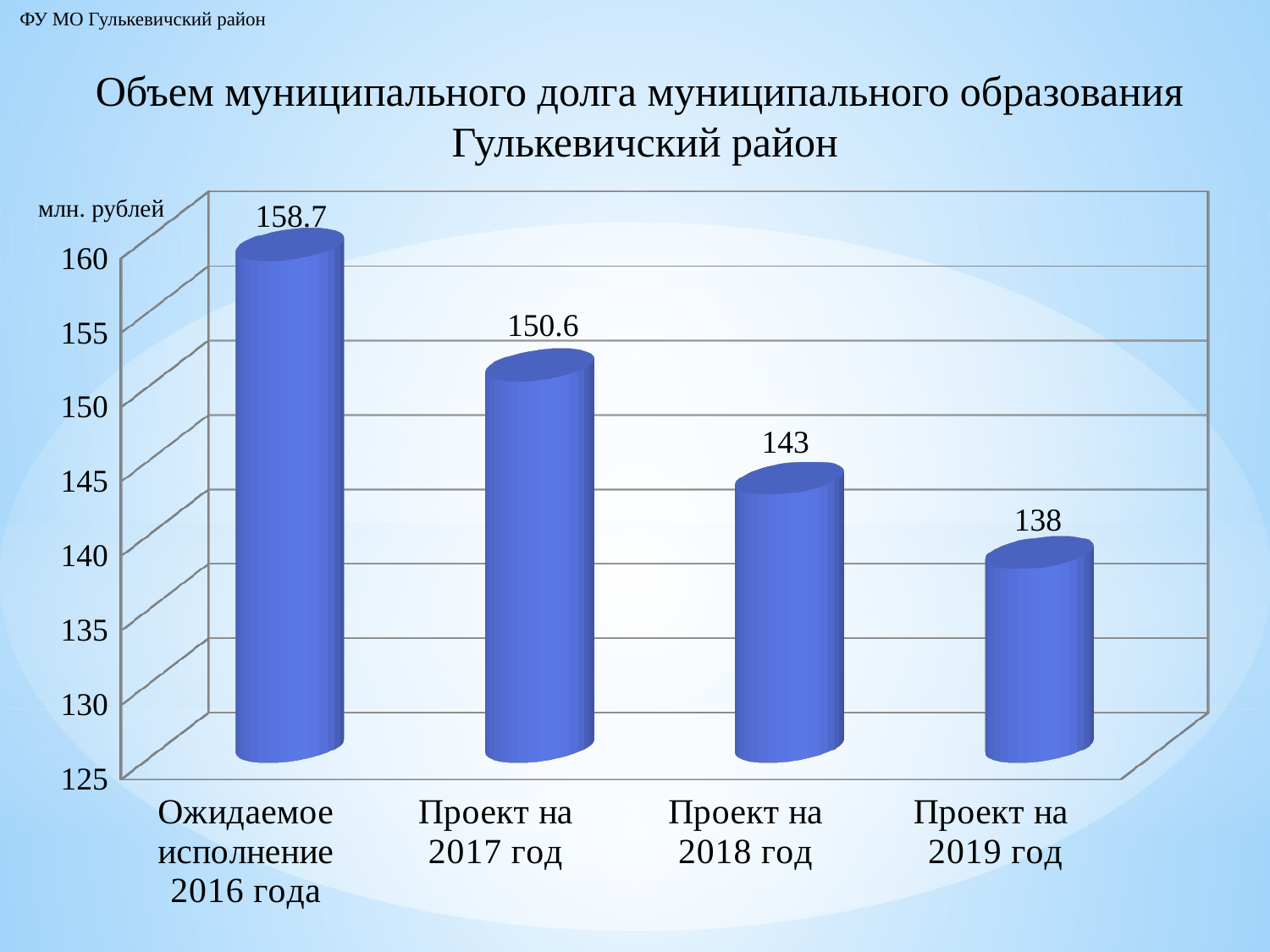
What is the difference between the values for Проект на 2017 год and Проект на 2018 год? 7.6 What is the difference between the values for Ожидаемое исполнение 2016 года and Проект на 2019 год? 20.7 Which is larger, the value for Проект на 2018 год or Проект на 2019 год? Проект на 2018 год Which category has the highest value? Ожидаемое исполнение 2016 года Do the values rise or fall from left to right along the x axis? Fall Which category has the lowest value? Проект на 2019 год What is the value for Проект на 2017 год? 150.6 What is the value for Проект на 2019 год? 138 What is the value for Проект на 2018 год? 143 What is the value for Ожидаемое исполнение 2016 года? 158.7 How many categories are shown on the chart? 4 What kind of chart is shown on the slide? Bar chart